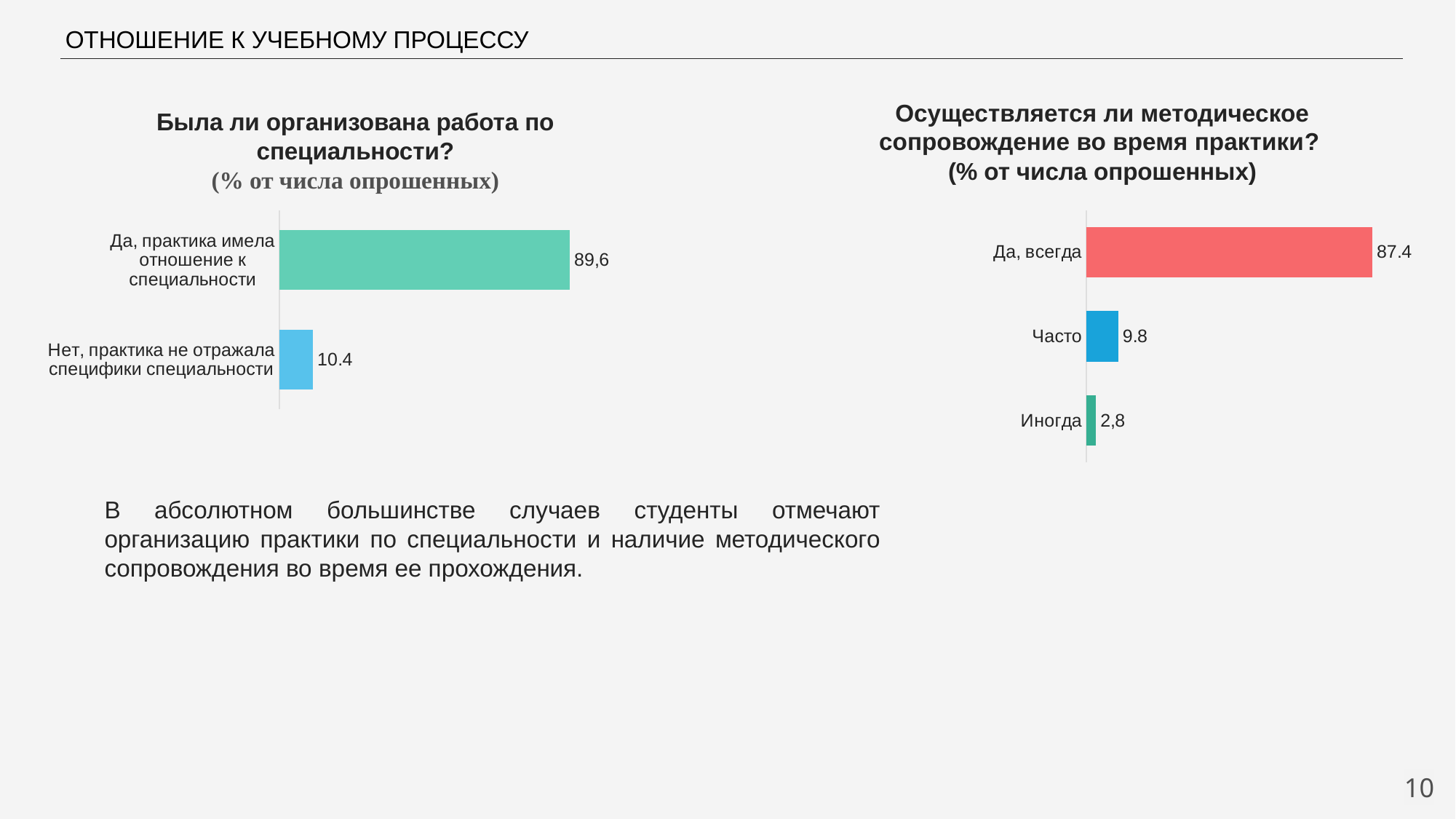
In the right chart 'Осуществляется ли методическое сопровождение во время практики?', how many categories are shown? 3 In the right chart 'Осуществляется ли методическое сопровождение во время практики?', which category has the lowest value? Иногда What type of chart is the right chart 'Осуществляется ли методическое сопровождение во время практики?'? Bar chart In the left chart 'Была ли организована работа по специальности?', how many categories are shown? 2 In the right chart 'Осуществляется ли методическое сопровождение во время практики?', what is the value for 'Да, всегда'? 87.4 In the left chart 'Была ли организована работа по специальности?', what is the value for 'Да, практика имела отношение к специальности'? 89,6 In the right chart 'Осуществляется ли методическое сопровождение во время практики?', which category has the highest value? Да, всегда In the right chart 'Осуществляется ли методическое сопровождение во время практики?', what is the value for 'Иногда'? 2,8 In the left chart 'Была ли организована работа по специальности?', what is the difference between the 'Да' and 'Нет' values? 79.2 In the left chart 'Была ли организована работа по специальности?', what is the value for 'Нет, практика не отражала специфики специальности'? 10.4 In the right chart 'Осуществляется ли методическое сопровождение во время практики?', what is the difference between 'Часто' and 'Иногда'? 7.0 In the right chart 'Осуществляется ли методическое сопровождение во время практики?', what is the value for 'Часто'? 9.8